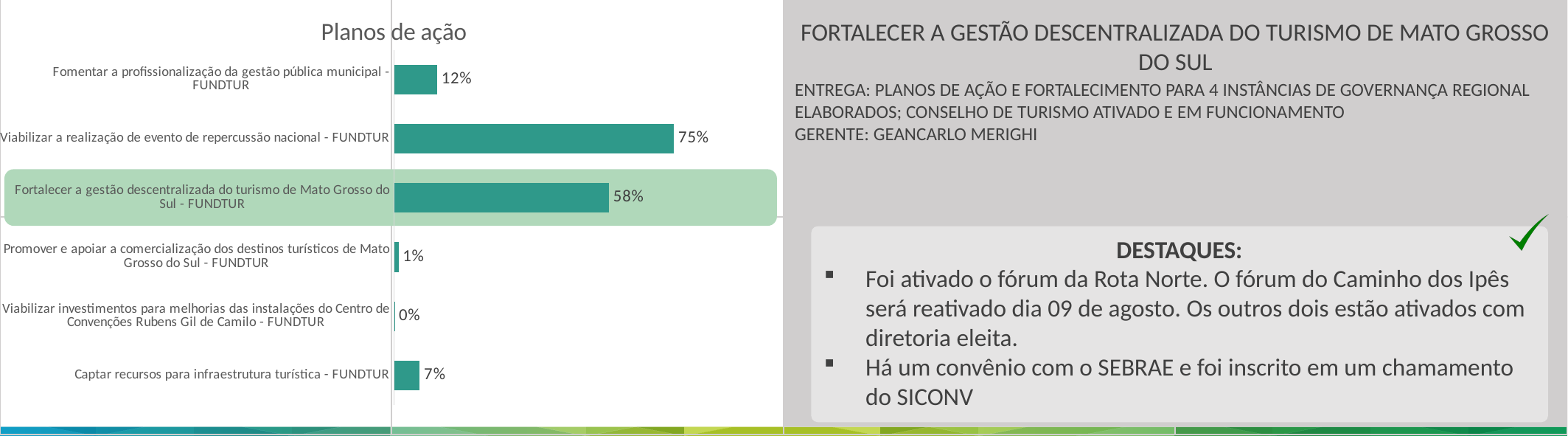
What is the difference between the values for "Viabilizar a realização de evento de repercussão nacional - FUNDTUR" and "Fortalecer a gestão descentralizada do turismo de Mato Grosso do Sul - FUNDTUR"? 17% Which action plan has the highest value? Viabilizar a realização de evento de repercussão nacional - FUNDTUR What is the value for "Fomentar a profissionalização da gestão pública municipal - FUNDTUR"? 12% What is the value for "Captar recursos para infraestrutura turística - FUNDTUR"? 7% What is the value for "Fortalecer a gestão descentralizada do turismo de Mato Grosso do Sul - FUNDTUR"? 58% Which is larger: the value for "Fomentar a profissionalização da gestão pública municipal - FUNDTUR" or for "Captar recursos para infraestrutura turística - FUNDTUR"? Fomentar a profissionalização da gestão pública municipal - FUNDTUR What is the value for "Promover e apoiar a comercialização dos destinos turísticos de Mato Grosso do Sul - FUNDTUR"? 1% What is the title of the chart? Planos de ação How many action plans (categories) are shown in the chart? 6 What is the value for "Viabilizar a realização de evento de repercussão nacional - FUNDTUR"? 75% What kind of chart is shown on the slide? Bar chart Which action plan has the lowest value? Viabilizar investimentos para melhorias das instalações do Centro de Convenções Rubens Gil de Camilo - FUNDTUR